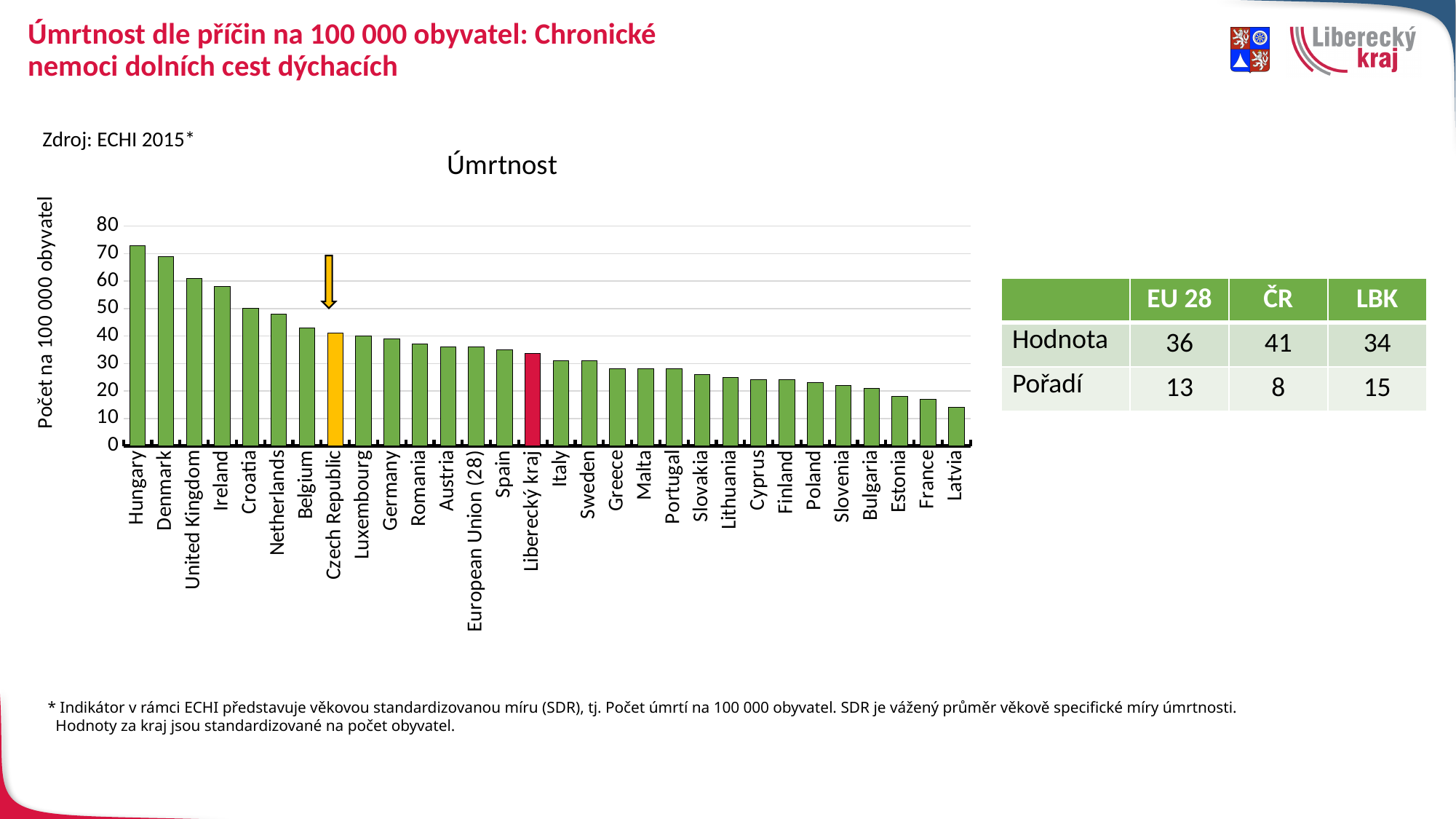
Which has the larger value, Denmark or Ireland? Denmark Is the value for Ireland greater or less than 60? less Which country has the lowest value in the chart? Latvia Do the values rise or fall from left to right along the x axis? fall What kind of chart is shown on the slide? bar chart Is the value for Hungary greater or less than 60? greater Which country has the highest value in the chart? Hungary How many bars (categories) are plotted in the chart? 30 Is the value for Latvia greater or less than 10? greater According to the table on the slide, what is the value (Hodnota) for ČR? 41 What colour is the bar for Liberecký kraj? red According to the table on the slide, what is the difference between the value for ČR and the value for LBK? 7